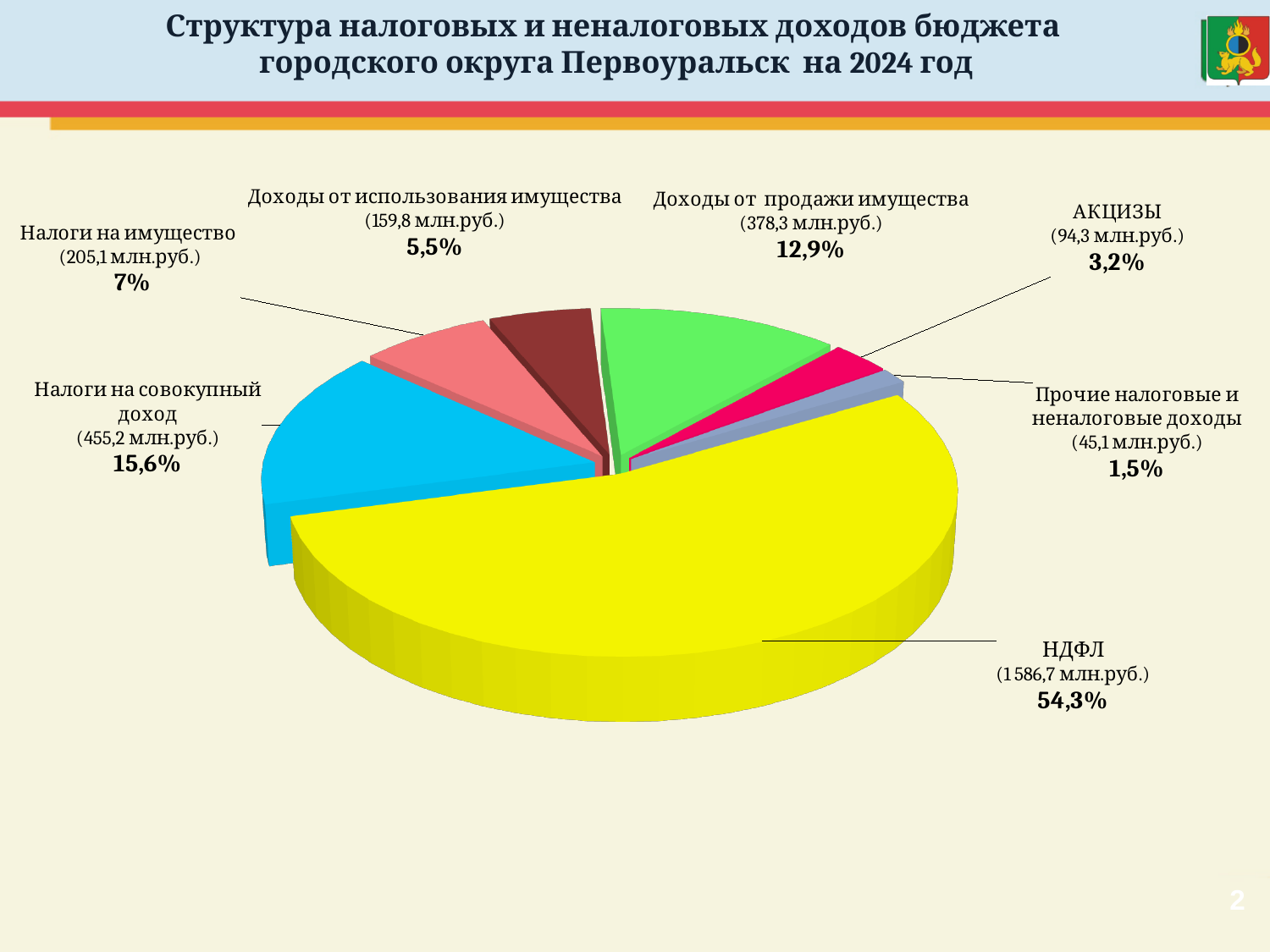
Каким цветом на диаграмме показан сектор НДФЛ? Жёлтым Что больше: доля налогов на имущество или доля доходов от использования имущества? Налоги на имущество Какова сумма налогов на совокупный доход? 455,2 млн.руб. Какая категория имеет наибольшую долю в структуре доходов? НДФЛ Какова сумма доходов от продажи имущества (млн.руб.)? 378,3 млн.руб. Сколько категорий доходов показано на диаграмме? 7 Какой тип диаграммы показан на слайде? Круговая диаграмма Какую долю составляют акцизы? 3,2% Какая категория имеет наименьшую долю в структуре доходов? Прочие налоговые и неналоговые доходы Какую долю составляет НДФЛ в структуре доходов? 54,3% На сколько процентных пунктов доля налогов на совокупный доход больше доли доходов от продажи имущества? 2,7 Какова сумма прочих налоговых и неналоговых доходов? 45,1 млн.руб.